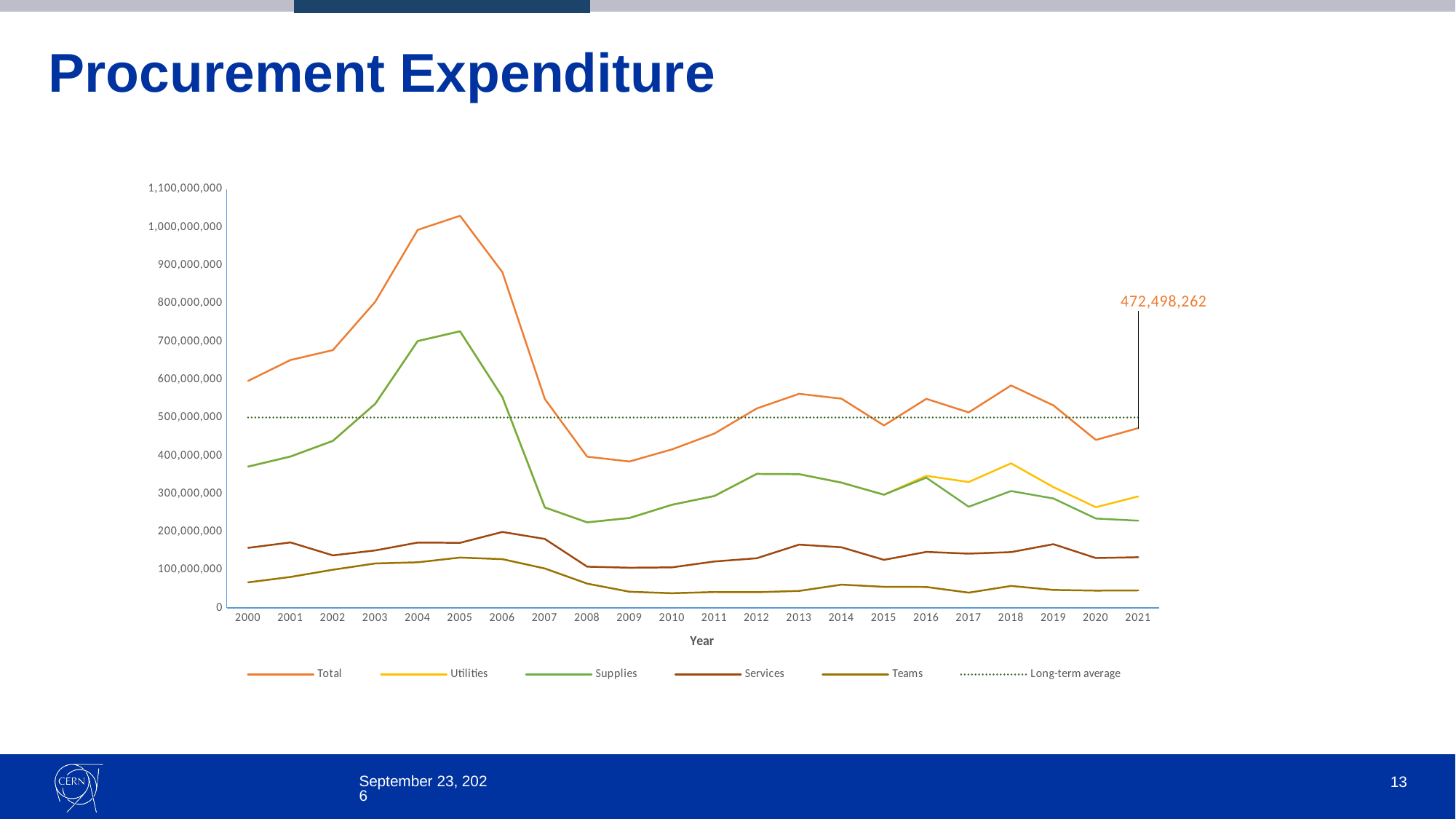
In which year is the Total series at its highest? 2005 How many series does the legend list? 6 Which series is drawn as a dotted line? Long-term average Does the Total series rise or fall from 2002 to 2005? rise How many years are shown on the x axis? 22 Is the Total value for 2008 greater or less than 500,000,000? less What kind of chart is shown on the slide? line chart What is the Total procurement expenditure value labelled for 2021? 472,498,262 In 2018, which is larger: Utilities or Supplies? Utilities Is the Total value for 2004 greater or less than 900,000,000? greater Is the Teams value for 2010 greater or less than 100,000,000? less